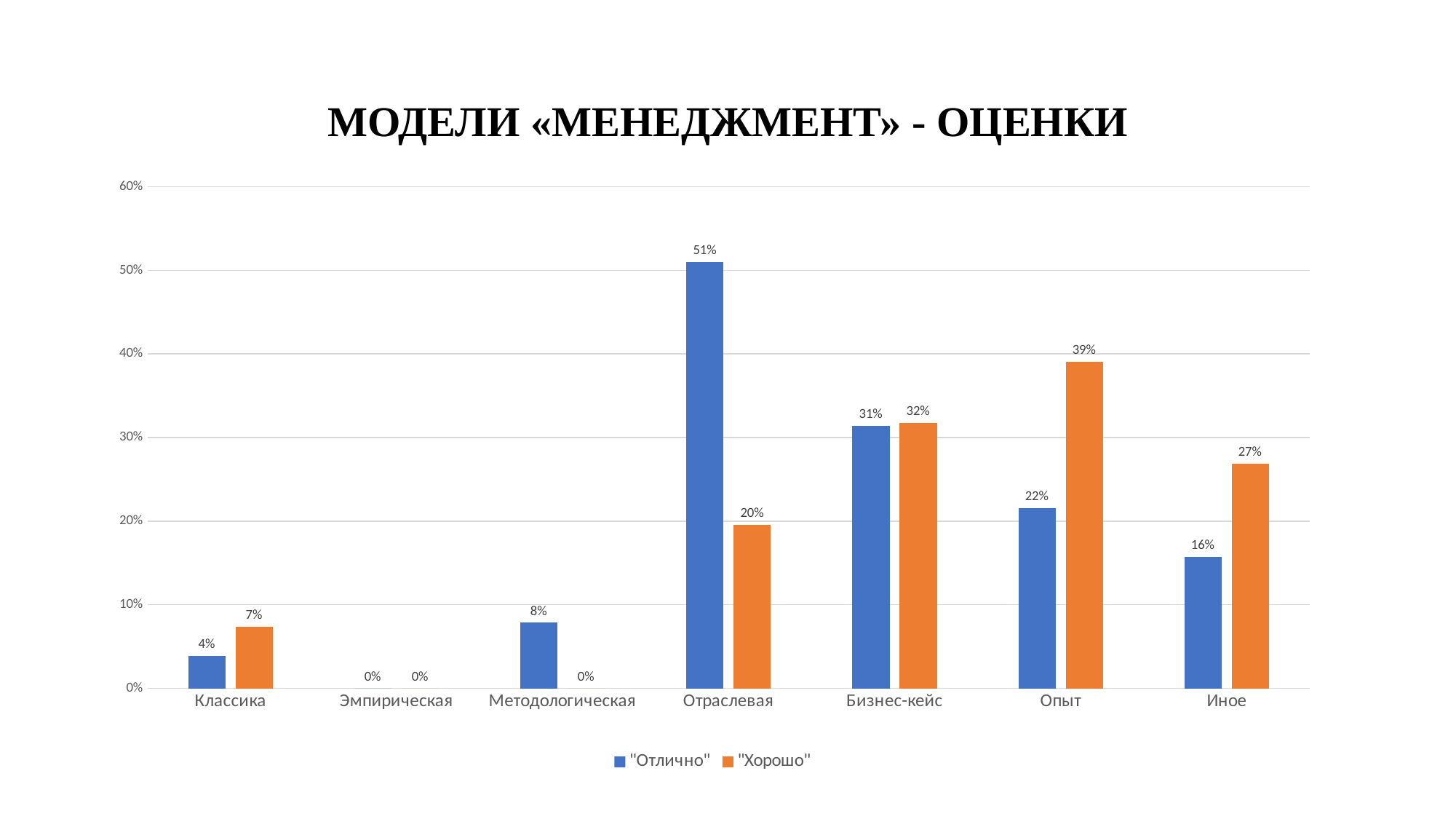
How many series does the legend list? 2 What is the "Хорошо" value for Опыт? 39% What is the difference between the "Отлично" and "Хорошо" values for Отраслевая? 31% Which category has the highest "Отлично" value? Отраслевая What kind of chart is shown? bar chart Is the "Отлично" value for Опыт greater or less than 20%? greater For Иное, which is larger: "Отлично" or "Хорошо"? "Хорошо" What is the title of the chart? МОДЕЛИ «МЕНЕДЖМЕНТ» - ОЦЕНКИ Which category has the highest "Хорошо" value? Опыт What is the "Отлично" value for Классика? 4% How many categories are shown on the x axis? 7 What is the "Отлично" value for Отраслевая? 51%